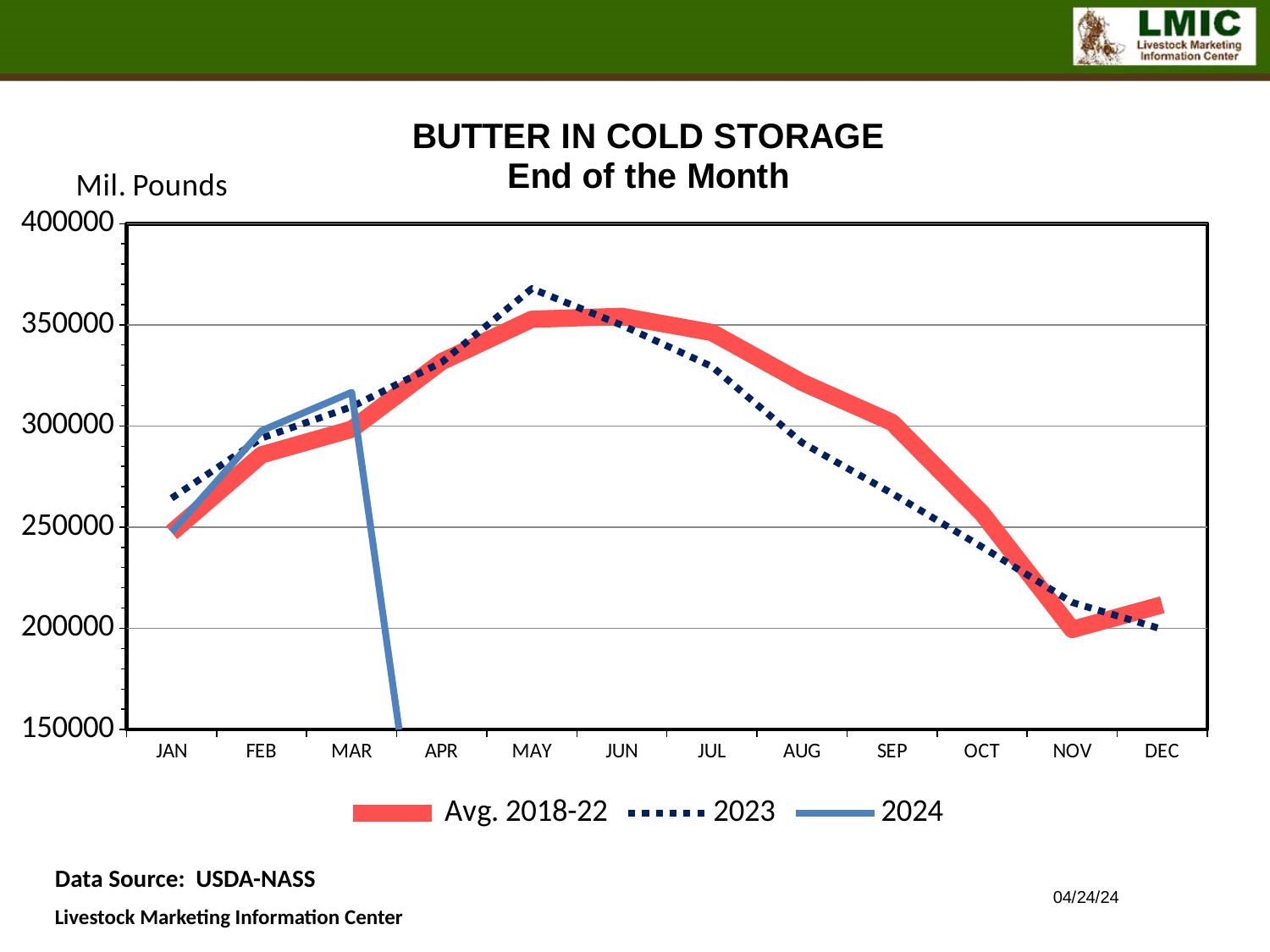
In AUG, which series is higher: Avg. 2018-22 or 2023? Avg. 2018-22 How many months are shown along the x axis? 12 In which month does the 2023 series reach its highest value? MAY How many series does the legend list? 3 In which month does the 2023 series reach its lowest value? DEC What kind of chart is shown on the slide? line chart Is the 2024 value for MAR greater or less than 300000? greater Does the 2023 series rise or fall from MAY to DEC? fall What unit is shown on the y axis label? Mil. Pounds In which month is the Avg. 2018-22 series at its lowest? NOV Is the 2023 value for MAY greater or less than 350000? greater Is the Avg. 2018-22 value for NOV greater or less than 250000? less